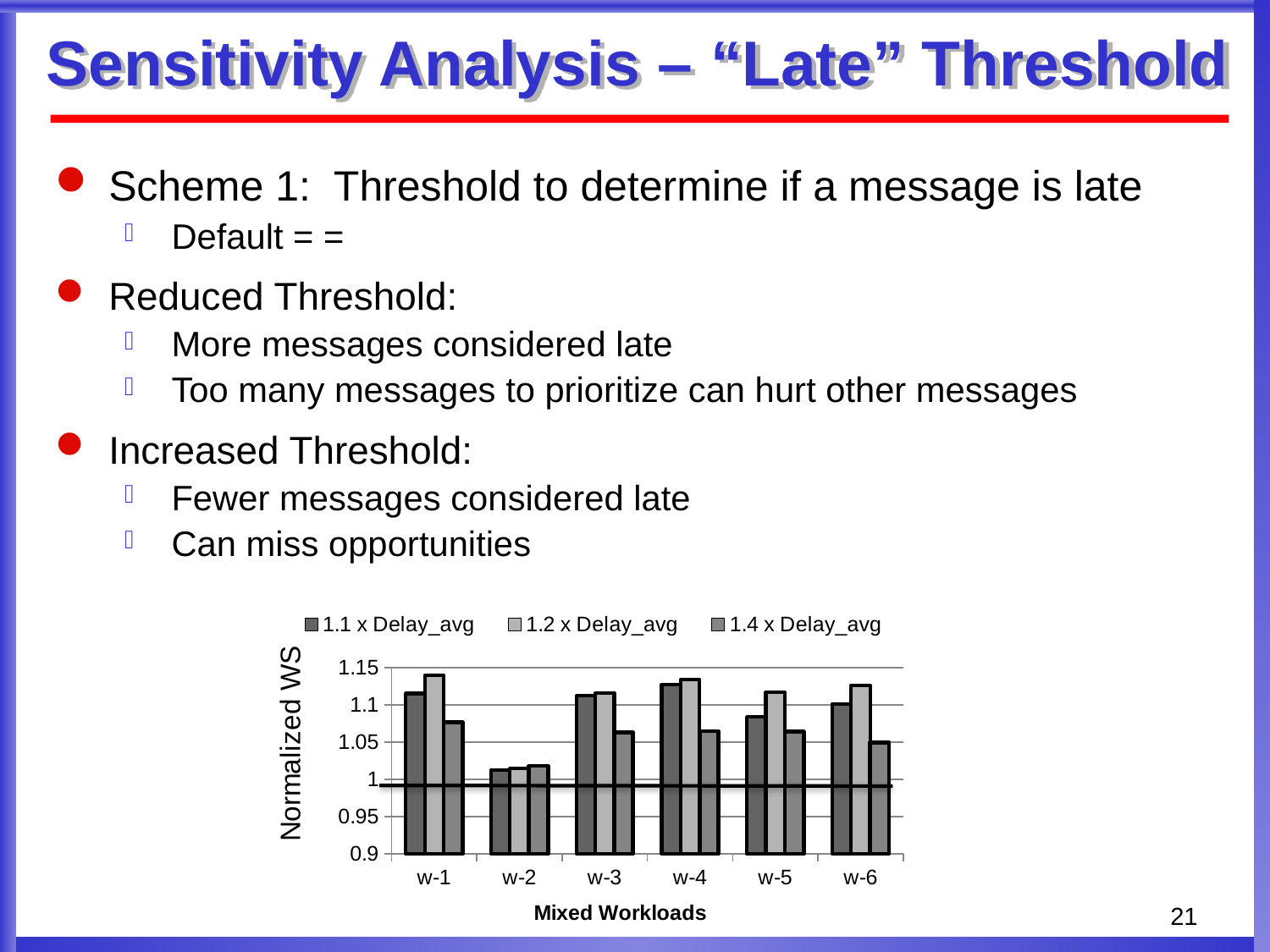
For w-1, which is larger: the 1.2 x Delay_avg value or the 1.4 x Delay_avg value? 1.2 x Delay_avg Is the 1.1 x Delay_avg value for w-2 greater or less than 1.05? less For w-5, which is larger: the 1.1 x Delay_avg value or the 1.2 x Delay_avg value? 1.2 x Delay_avg Which workload has the lowest Normalized WS values across all three series? w-2 What kind of chart is shown on the slide? bar chart How many series does the chart's legend list? 3 Is the 1.4 x Delay_avg value for w-4 greater or less than 1.1? less For the 1.4 x Delay_avg series, which workload has the lowest Normalized WS? w-2 Is the 1.1 x Delay_avg value for w-3 greater or less than 1.05? greater What is the title of the chart's y axis? Normalized WS How many workload categories are shown on the x axis of the chart? 6